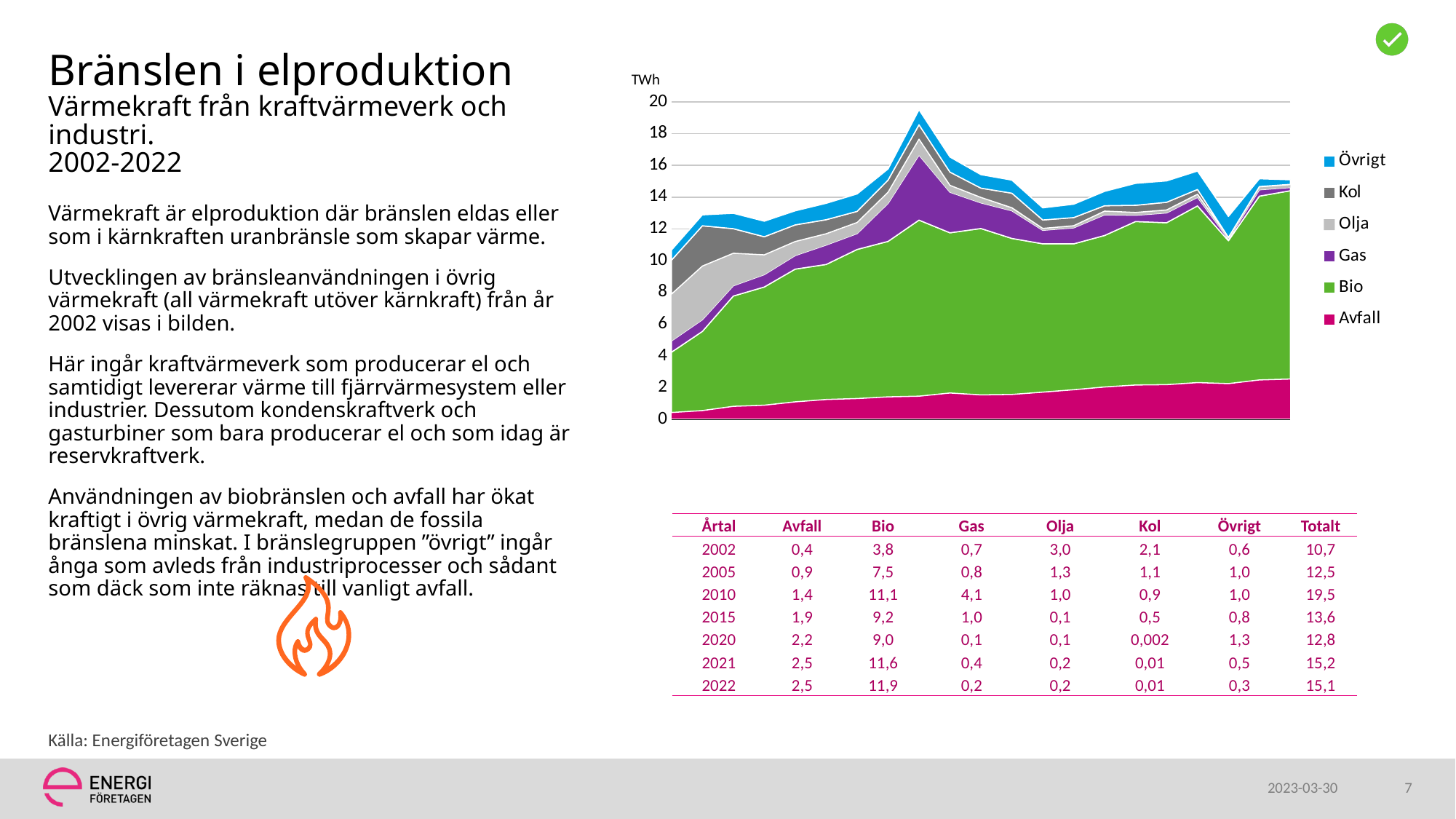
Is the highest point of the stacked total in the chart greater or less than 18? greater According to the table below the chart, which fuel had the lowest value in 2022? Kol According to the table below the chart, what was the Totalt value in 2010? 19,5 What unit is shown at the top of the chart's vertical axis? TWh Does the Avfall (bottom) area rise or fall from left to right across the chart? rise How many series does the chart's legend list? 6 According to the table below the chart, which fuel had the highest value in 2022? Bio Is the stacked total at the far left of the chart greater or less than 12? less What kind of chart is shown on the slide? stacked area chart According to the table below the chart, what was the Bio value in 2022? 11,9 Which series is shown in green in the chart? Bio According to the table below the chart, what is the difference between the Bio and Avfall values in 2022? 9,4